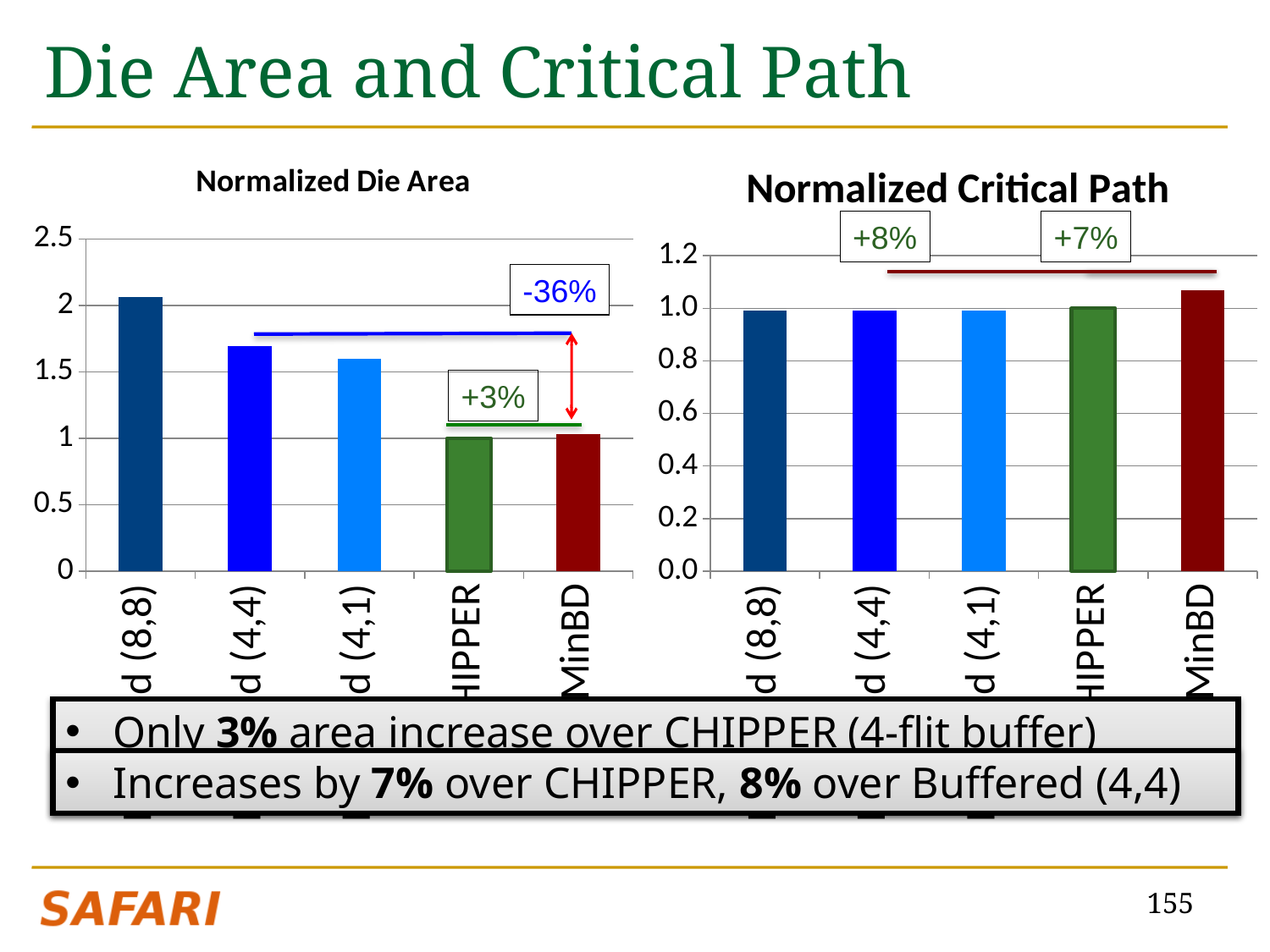
In the Normalized Die Area chart, which category has the highest value? d (8,8) What are the two percentage annotations shown above the bars in the Normalized Critical Path chart? +8% and +7% In the Normalized Die Area chart, is the value for d (4,4) greater or less than 1.5? greater In the Normalized Die Area chart, is the value for MinBD greater or less than 1.5? less What kind of chart is the Normalized Die Area chart? bar chart In the Normalized Die Area chart, which is larger, the value for d (4,4) or the value for MinBD? d (4,4) In the Normalized Critical Path chart, which is larger, the value for MinBD or the value for d (8,8)? MinBD In the Normalized Critical Path chart, is the value for MinBD greater or less than 1.0? greater What percentage annotation is shown in blue above the bars in the Normalized Die Area chart? -36% How many bars does the Normalized Critical Path chart show? 5 In the Normalized Critical Path chart, which category has the highest value? MinBD